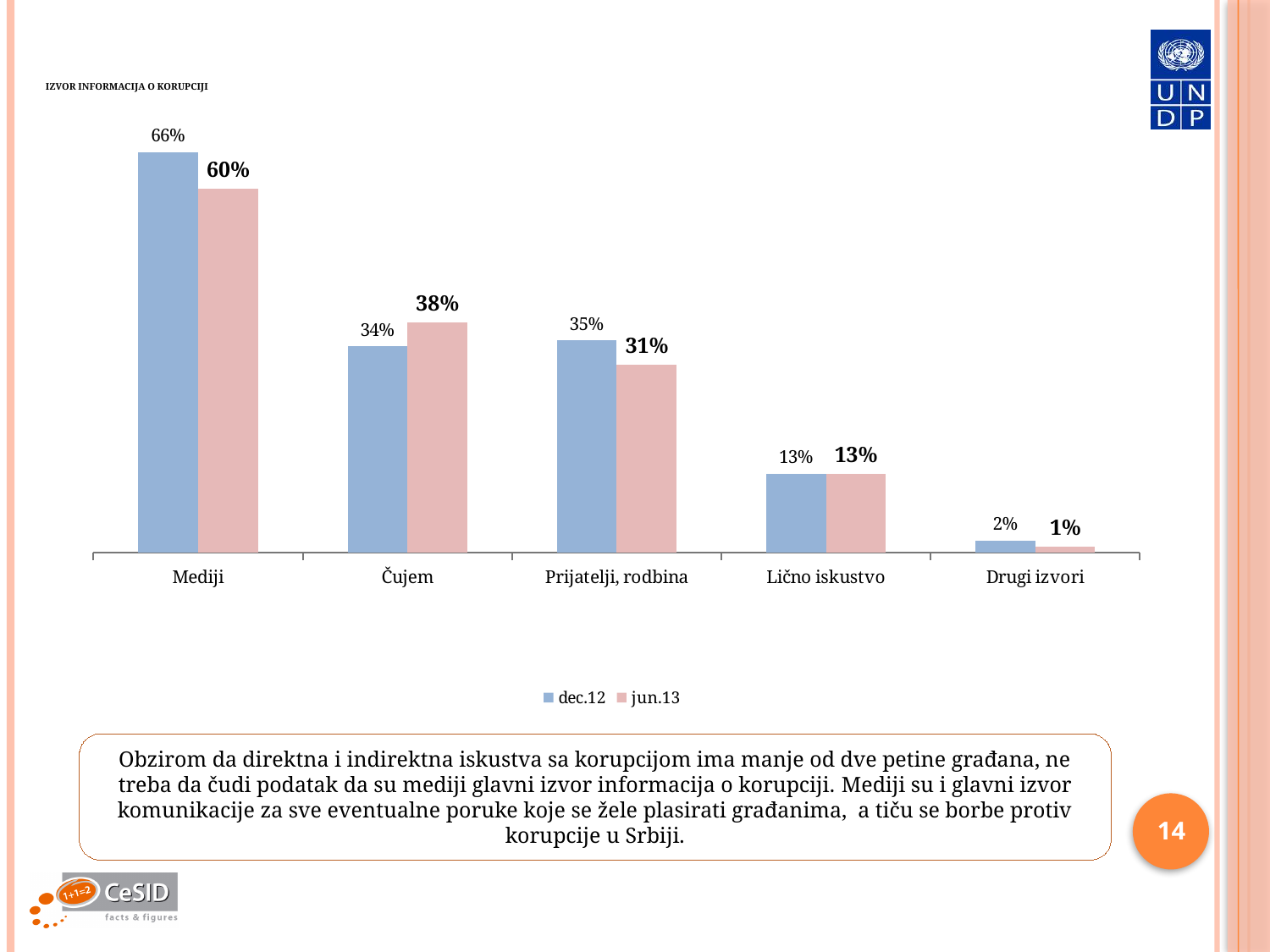
How many categories are shown on the x axis? 5 What is the value for Prijatelji, rodbina in the jun.13 series? 31% What is the value for Čujem in the jun.13 series? 38% What is the value for Drugi izvori in the dec.12 series? 2% How many series does the legend list? 2 Which is larger for Čujem: the dec.12 value or the jun.13 value? jun.13 What is the difference between the dec.12 and jun.13 values for Mediji? 6% Which category has the highest value in the jun.13 series? Mediji What is the value for Mediji in the dec.12 series? 66% Which category has the lowest value in the dec.12 series? Drugi izvori What kind of chart is shown on the slide? Bar chart What are the two series named in the legend? dec.12 and jun.13